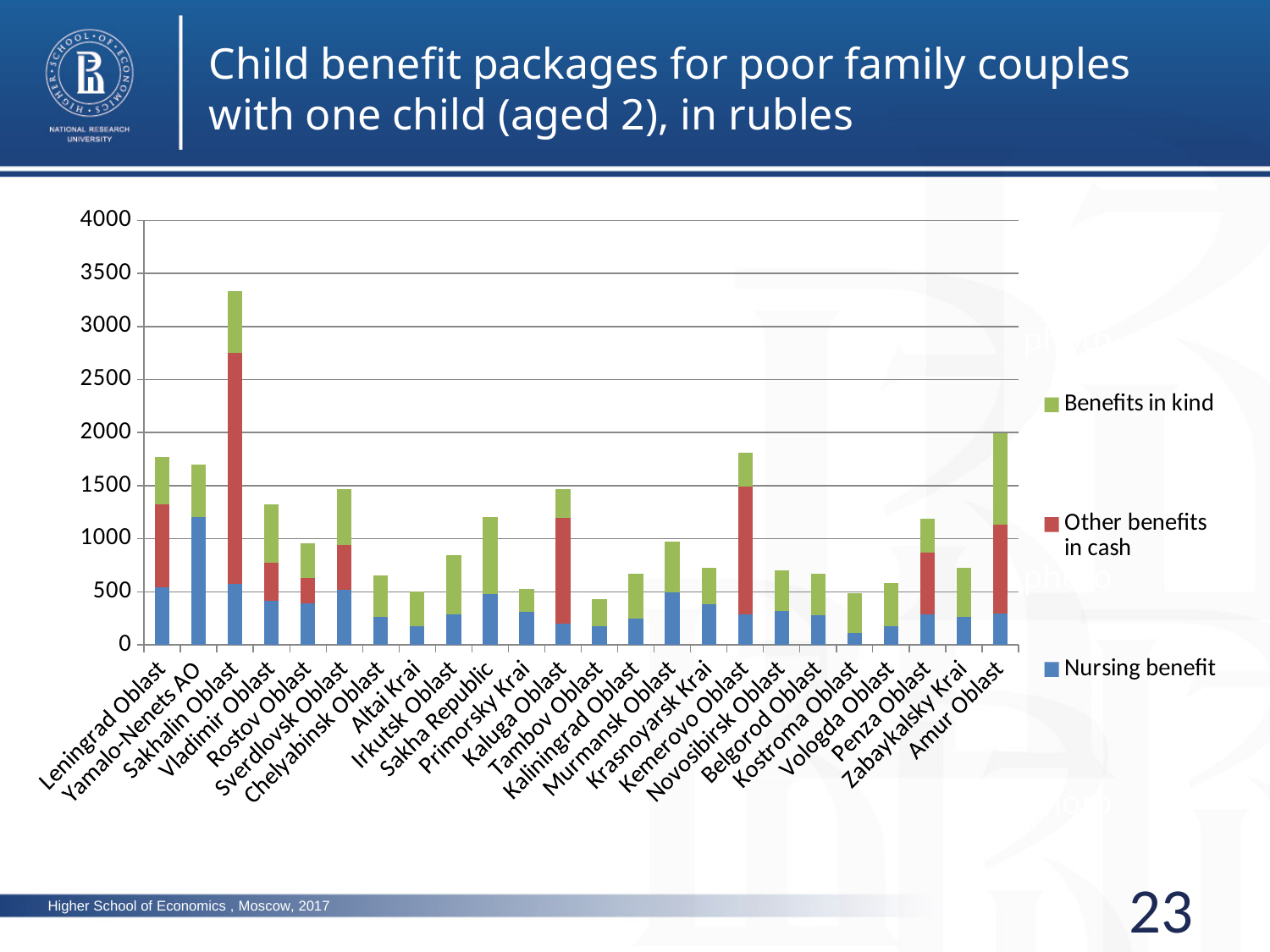
Is the total value for Sakhalin Oblast greater or less than 3000? greater Which has the larger Nursing benefit, Yamalo-Nenets AO or Leningrad Oblast? Yamalo-Nenets AO Which series is shown in green in the legend? Benefits in kind What kind of chart is shown on the slide? Stacked bar chart Is the total value for Tambov Oblast greater or less than 500? less Is the total value for Vladimir Oblast greater or less than 1000? greater Which has the larger total, Kemerovo Oblast or Krasnoyarsk Krai? Kemerovo Oblast How many regions are shown along the x axis? 24 How many series does the legend list? 3 Which region has the highest total child benefit package? Sakhalin Oblast